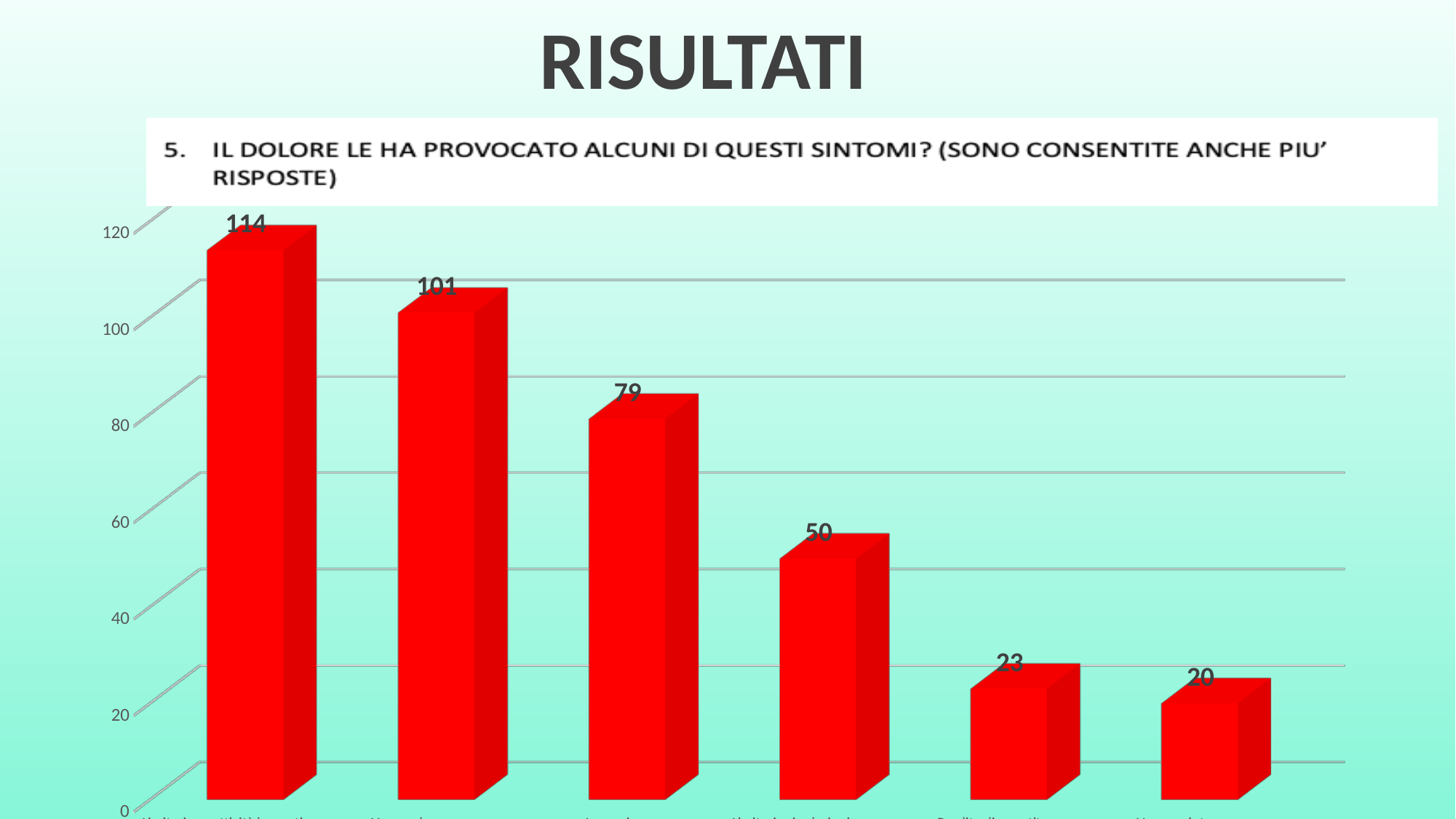
What is the value of the third bar from the left? 79 What is the difference between the first bar (114) and the second bar (101)? 13 What is the highest value shown in the chart? 114 What type of chart is shown on the slide? bar chart How many bars are plotted in the chart? 6 Which is larger, the fifth bar or the sixth bar? the fifth bar (23) What is the lowest value shown in the chart? 20 What is the value of the last (rightmost) bar? 20 What colour are the bars in the chart? red What is the value of the second bar from the left? 101 What is the value of the first (leftmost) bar? 114 Do the bar values rise or fall from left to right across the chart? fall